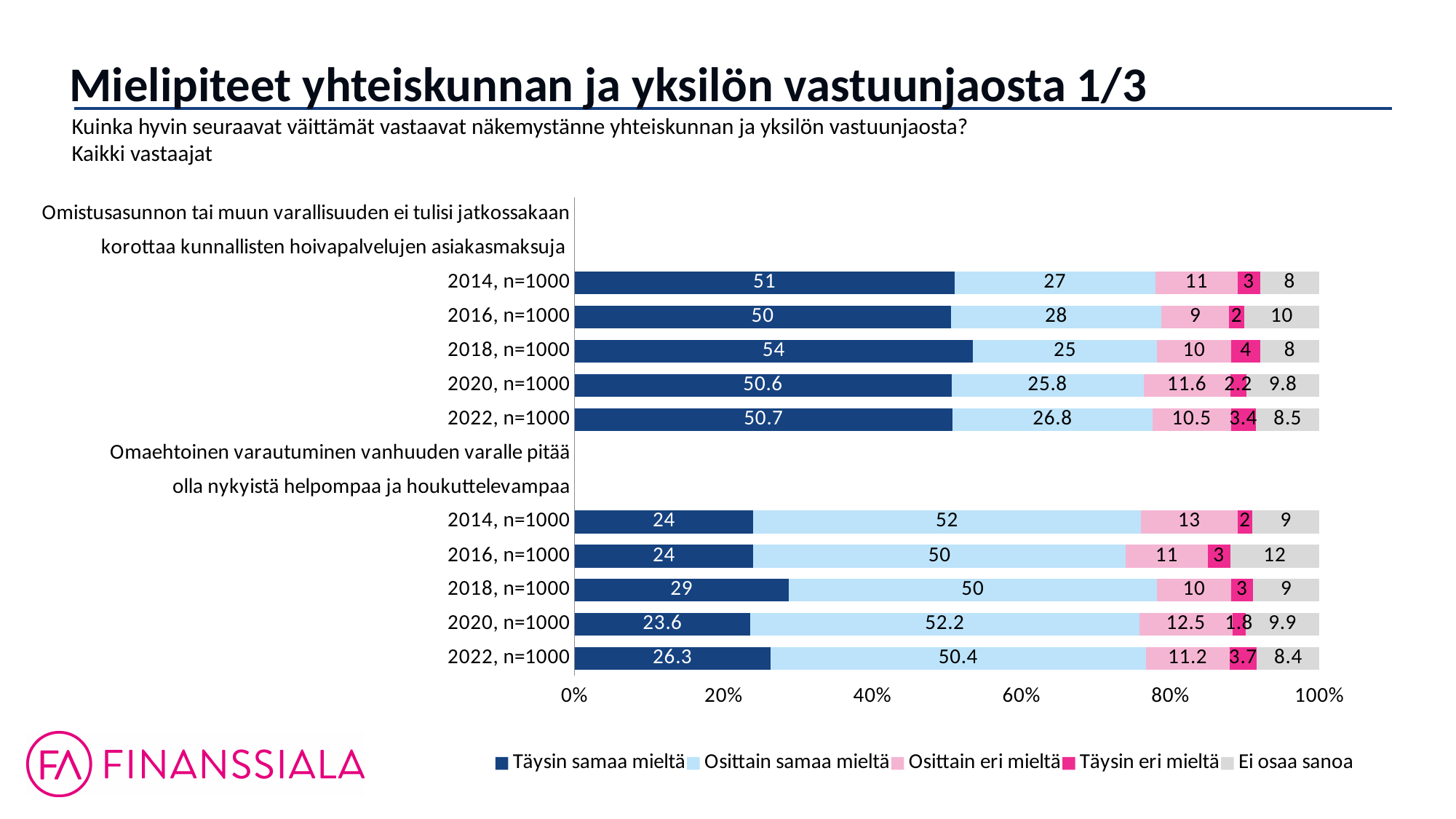
Under the statement 'Omaehtoinen varautuminen vanhuuden varalle pitää olla nykyistä helpompaa ja houkuttelevampaa', which year has the lowest 'Täysin samaa mieltä' value? 2020, n=1000 What is the 'Ei osaa sanoa' value for 2016, n=1000 under the statement 'Omaehtoinen varautuminen vanhuuden varalle pitää olla nykyistä helpompaa ja houkuttelevampaa'? 12 What is the title of the slide? Mielipiteet yhteiskunnan ja yksilön vastuunjaosta 1/3 What is the 'Osittain samaa mieltä' value for 2020, n=1000 under the statement 'Omaehtoinen varautuminen vanhuuden varalle pitää olla nykyistä helpompaa ja houkuttelevampaa'? 52.2 What is the 'Täysin samaa mieltä' value for 2018, n=1000 under the statement 'Omistusasunnon tai muun varallisuuden ei tulisi jatkossakaan korottaa kunnallisten hoivapalvelujen asiakasmaksuja'? 54 Is the 'Täysin samaa mieltä' value for 2022, n=1000 under the statement 'Omaehtoinen varautuminen vanhuuden varalle pitää olla nykyistä helpompaa ja houkuttelevampaa' greater or less than 40%? less Under the statement 'Omistusasunnon tai muun varallisuuden ei tulisi jatkossakaan korottaa kunnallisten hoivapalvelujen asiakasmaksuja', which year has the highest 'Täysin samaa mieltä' value? 2018, n=1000 What is the difference between the 'Täysin samaa mieltä' values for 2018, n=1000 and 2016, n=1000 under the statement 'Omaehtoinen varautuminen vanhuuden varalle pitää olla nykyistä helpompaa ja houkuttelevampaa'? 5 How many bars (year rows) are plotted in the chart? 10 What kind of chart is shown on the slide? Stacked bar chart How many series does the legend list? 5 Under the statement 'Omistusasunnon tai muun varallisuuden ei tulisi jatkossakaan korottaa kunnallisten hoivapalvelujen asiakasmaksuja', is the 'Täysin eri mieltä' value larger for 2018, n=1000 or for 2016, n=1000? 2018, n=1000